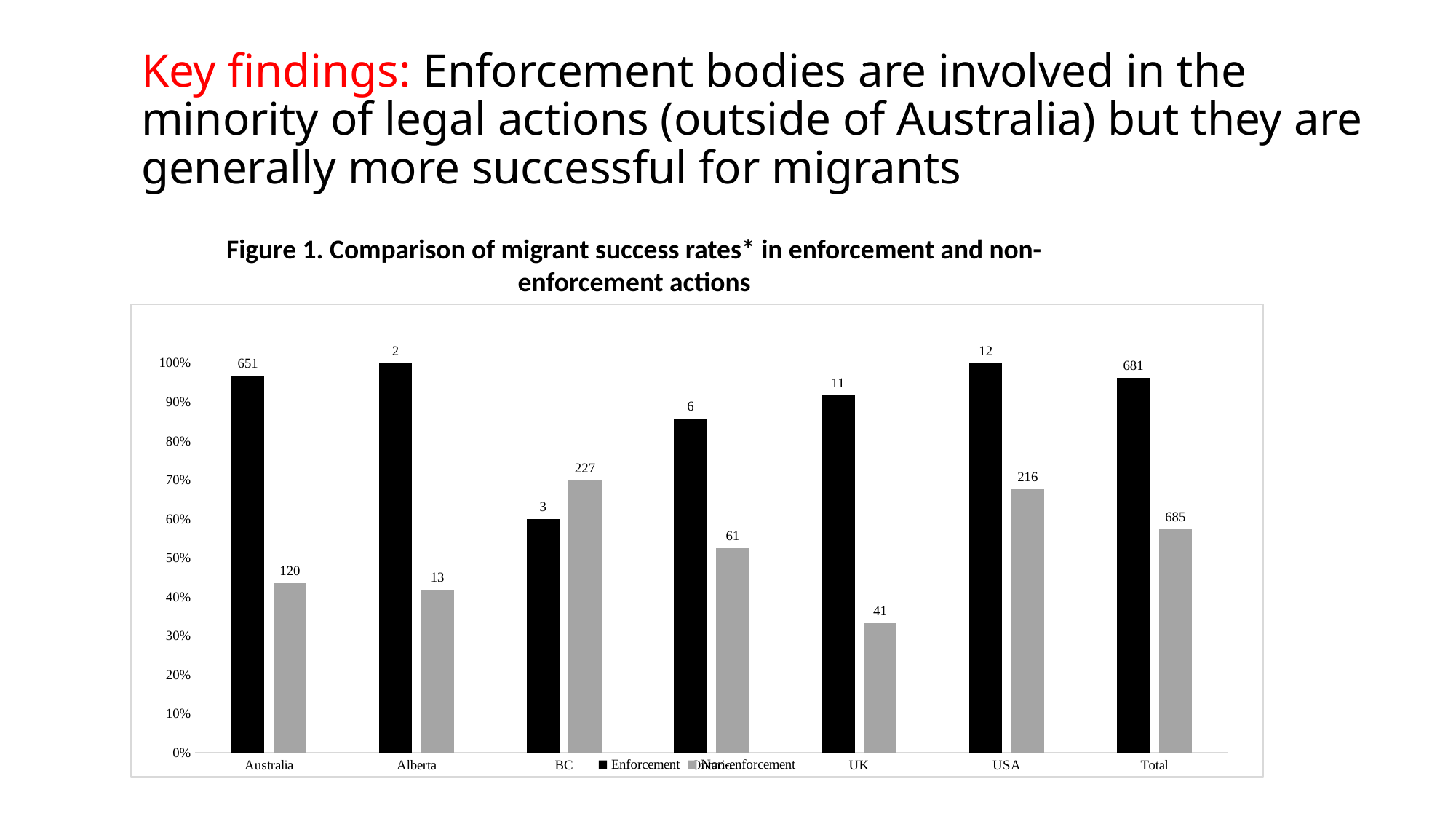
For the UK, which series has the higher success rate, Enforcement or Non-enforcement? Enforcement What kind of chart is shown in Figure 1? bar chart For BC, which series has the higher success rate, Enforcement or Non-enforcement? Non-enforcement What data label is printed above the Enforcement bar for Australia? 651 What data label is printed above the Non-enforcement bar for Total? 685 Is the Non-enforcement success rate for Australia greater or less than 50%? less How many series does the legend of Figure 1 list? 2 What is the Enforcement success rate for Alberta? 100% How many categories are shown along the x axis of Figure 1? 7 Is the Non-enforcement success rate for BC greater or less than 60%? greater Which category has the lowest Enforcement success rate? BC Which category has the lowest Non-enforcement success rate? UK